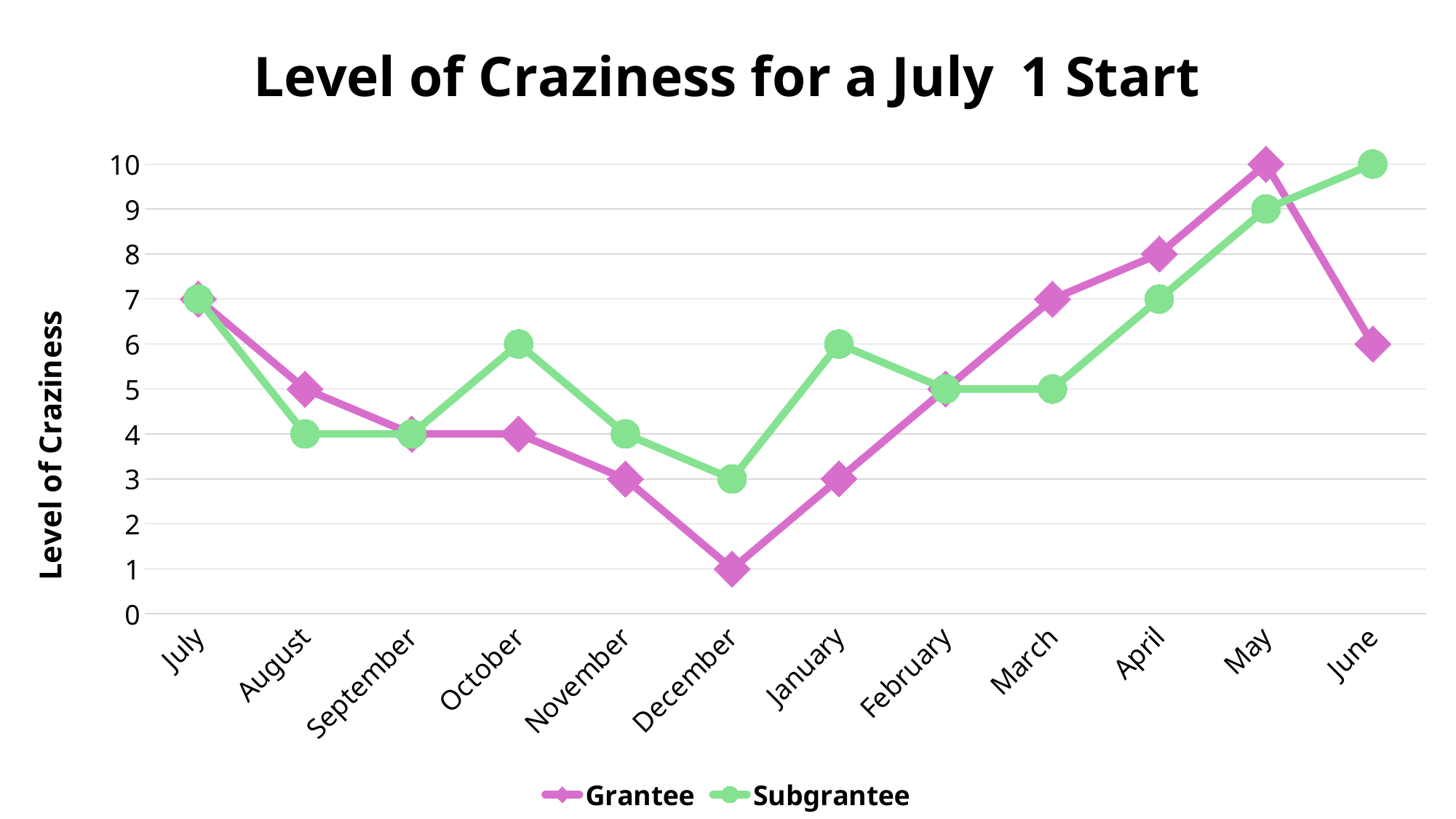
How many series does the legend list? 2 Is the Grantee value for April greater or less than 5? greater What type of chart is shown on the slide? Line chart In which month does the Grantee series reach its highest value? May What is the Subgrantee level of craziness in October? 6 What is the Grantee level of craziness in December? 1 In January, which series has the higher value, Grantee or Subgrantee? Subgrantee How many months are plotted along the x axis? 12 What is the difference between the Grantee and Subgrantee values in June? 4 In which month does the Subgrantee series reach its lowest value? December What is the title of the chart? Level of Craziness for a July 1 Start Does the Subgrantee series rise or fall from March to June? Rise